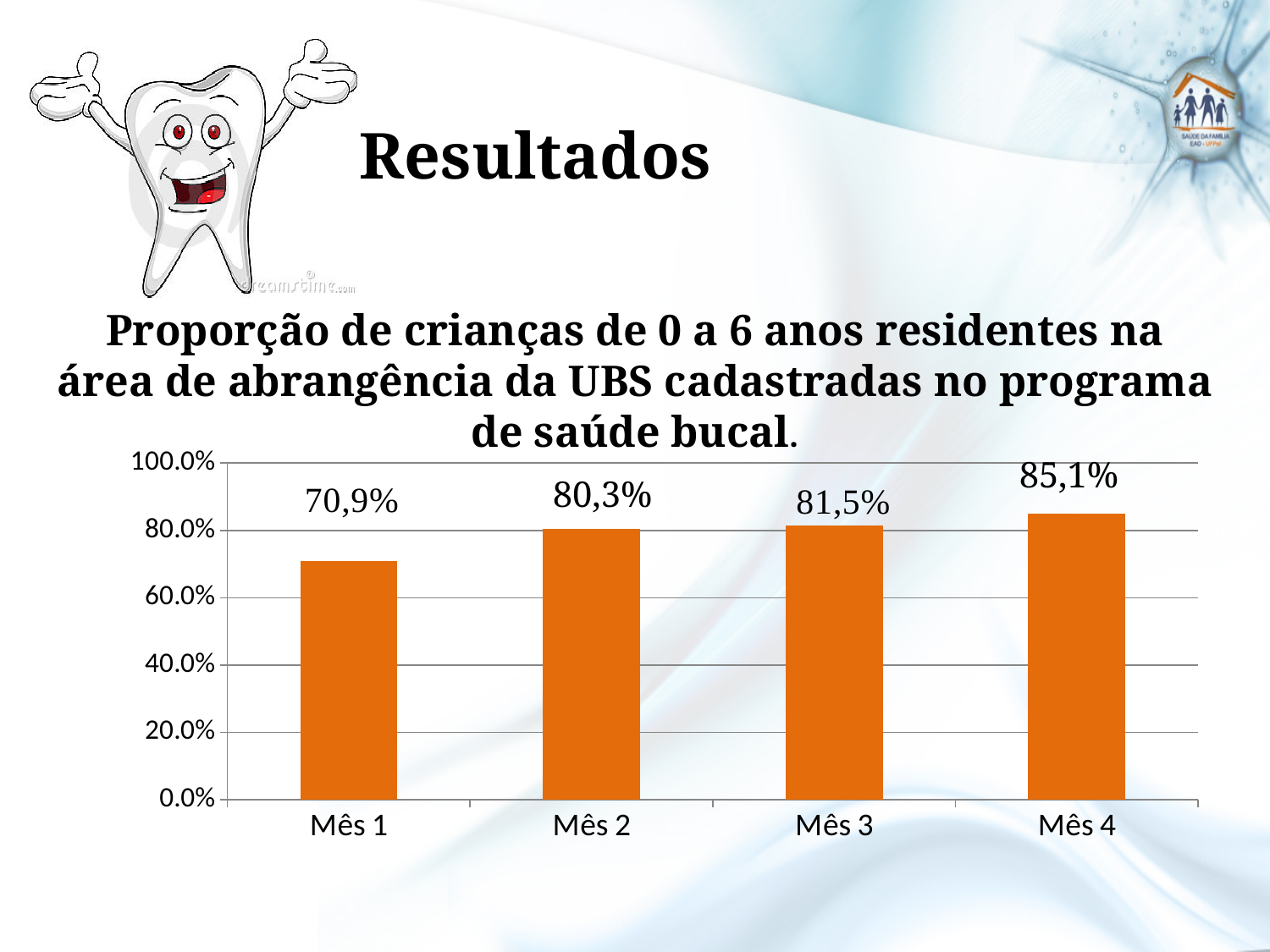
What is the value for Mês 3? 81,5% Which month has the highest value? Mês 4 Which month has the lowest value? Mês 1 What is the difference between the values for Mês 4 and Mês 1? 14,2% How many months are shown on the x axis? 4 What is the value for Mês 4? 85,1% Do the values rise or fall from Mês 1 to Mês 4? rise What is the value for Mês 1? 70,9% What is the value for Mês 2? 80,3% Which is larger, the value for Mês 2 or the value for Mês 1? Mês 2 What kind of chart is shown on the slide? bar chart Is the value for Mês 1 greater or less than 80.0%? less